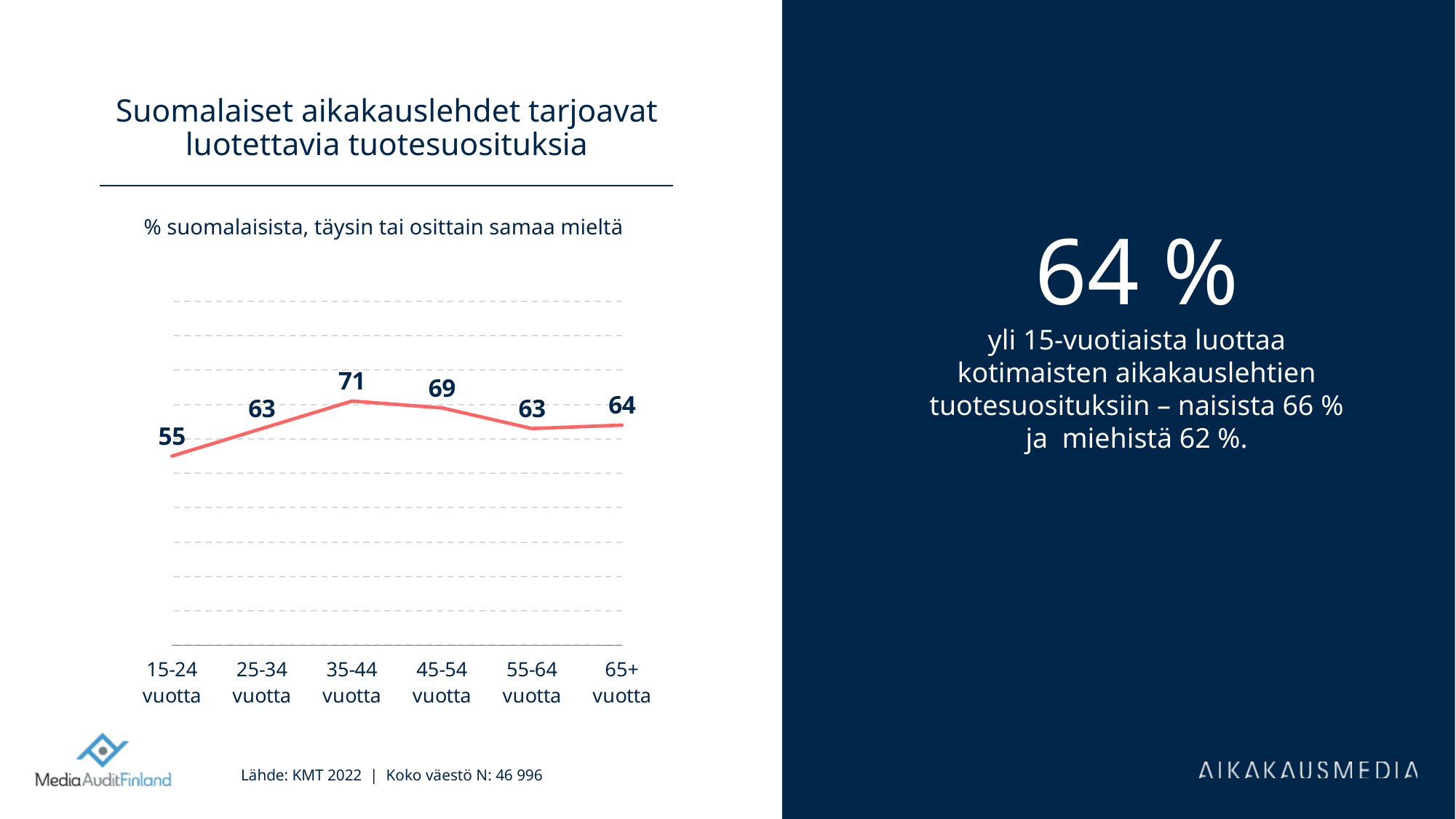
Which is larger, the value for 45-54 vuotta or the value for 55-64 vuotta? 45-54 vuotta What is the value for the 65+ vuotta age group? 64 What is the difference between the values for 35-44 vuotta and 15-24 vuotta? 16 What is the title of the chart? Suomalaiset aikakauslehdet tarjoavat luotettavia tuotesuosituksia What is the value for the 35-44 vuotta age group? 71 Which age group has the lowest value? 15-24 vuotta What is the value for the 15-24 vuotta age group? 55 How many age groups are plotted on the chart? 6 Do the values rise or fall from 15-24 vuotta to 35-44 vuotta? Rise What is the value for the 45-54 vuotta age group? 69 Which age group has the highest value? 35-44 vuotta What kind of chart is shown on the slide? Line chart